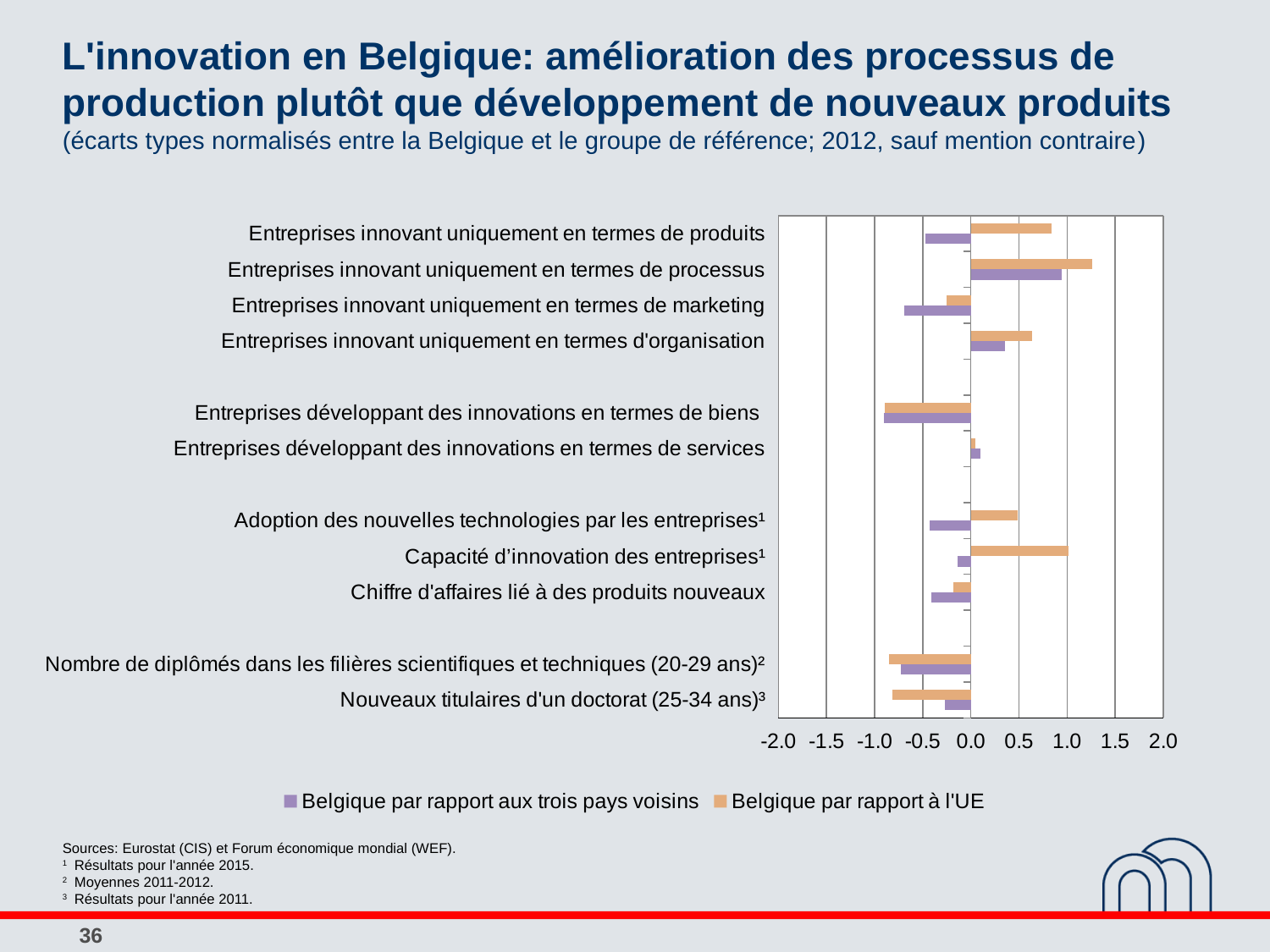
Is the value of 'Belgique par rapport à l'UE' for 'Entreprises innovant uniquement en termes de processus' greater or less than 1.0? greater Is the value of 'Belgique par rapport aux trois pays voisins' for 'Entreprises développant des innovations en termes de biens' greater or less than -0.5? less What kind of chart is shown on the slide? Bar chart Which category has the highest value for 'Belgique par rapport à l'UE'? Entreprises innovant uniquement en termes de processus How many categories are plotted on the chart? 11 What is the range of the horizontal axis? -2.0 to 2.0 What are the two series named in the legend? Belgique par rapport aux trois pays voisins; Belgique par rapport à l'UE Is the value of 'Belgique par rapport à l'UE' for 'Entreprises innovant uniquement en termes de produits' greater or less than 0.5? greater Which category has the highest value for 'Belgique par rapport aux trois pays voisins'? Entreprises innovant uniquement en termes de processus How many series does the legend list? 2 For 'Entreprises innovant uniquement en termes de processus', which series has the larger value? Belgique par rapport à l'UE